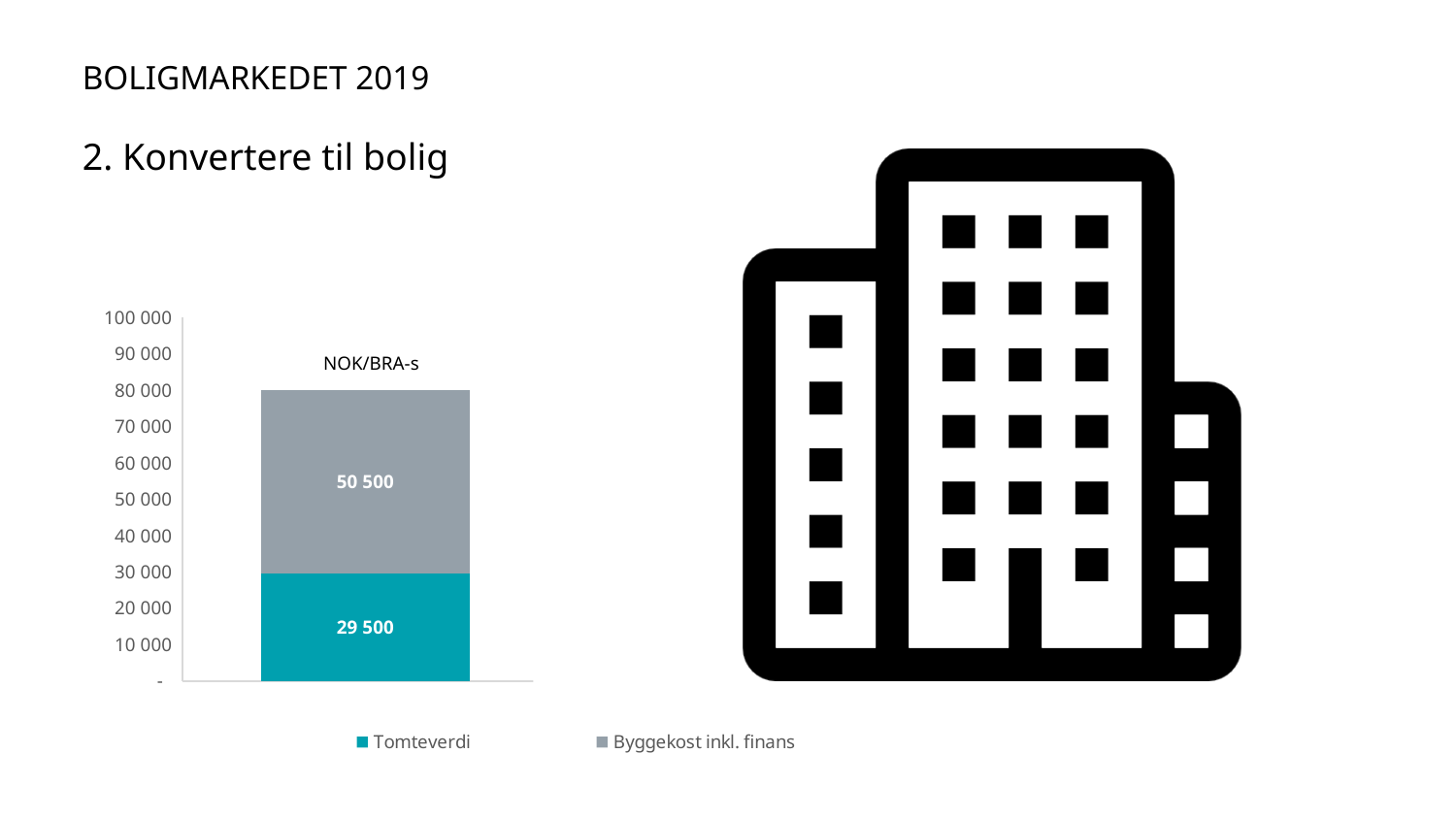
What is the value of the Tomteverdi segment in the stacked bar? 29 500 Which segment is larger, Tomteverdi or Byggekost inkl. finans? Byggekost inkl. finans Which series has the largest value in the stacked bar? Byggekost inkl. finans Which series has the smallest value in the stacked bar? Tomteverdi What colour is the Tomteverdi segment in the chart? Teal Is the total height of the stacked bar greater or less than 90 000? less How many bars are plotted in the chart? 1 What is the value of the Byggekost inkl. finans segment in the stacked bar? 50 500 How many series does the legend list? 2 What kind of chart is shown on the slide? Stacked bar chart What is the total of the stacked bar labelled NOK/BRA-s? 80 000 What is the difference between the Byggekost inkl. finans segment and the Tomteverdi segment? 21 000